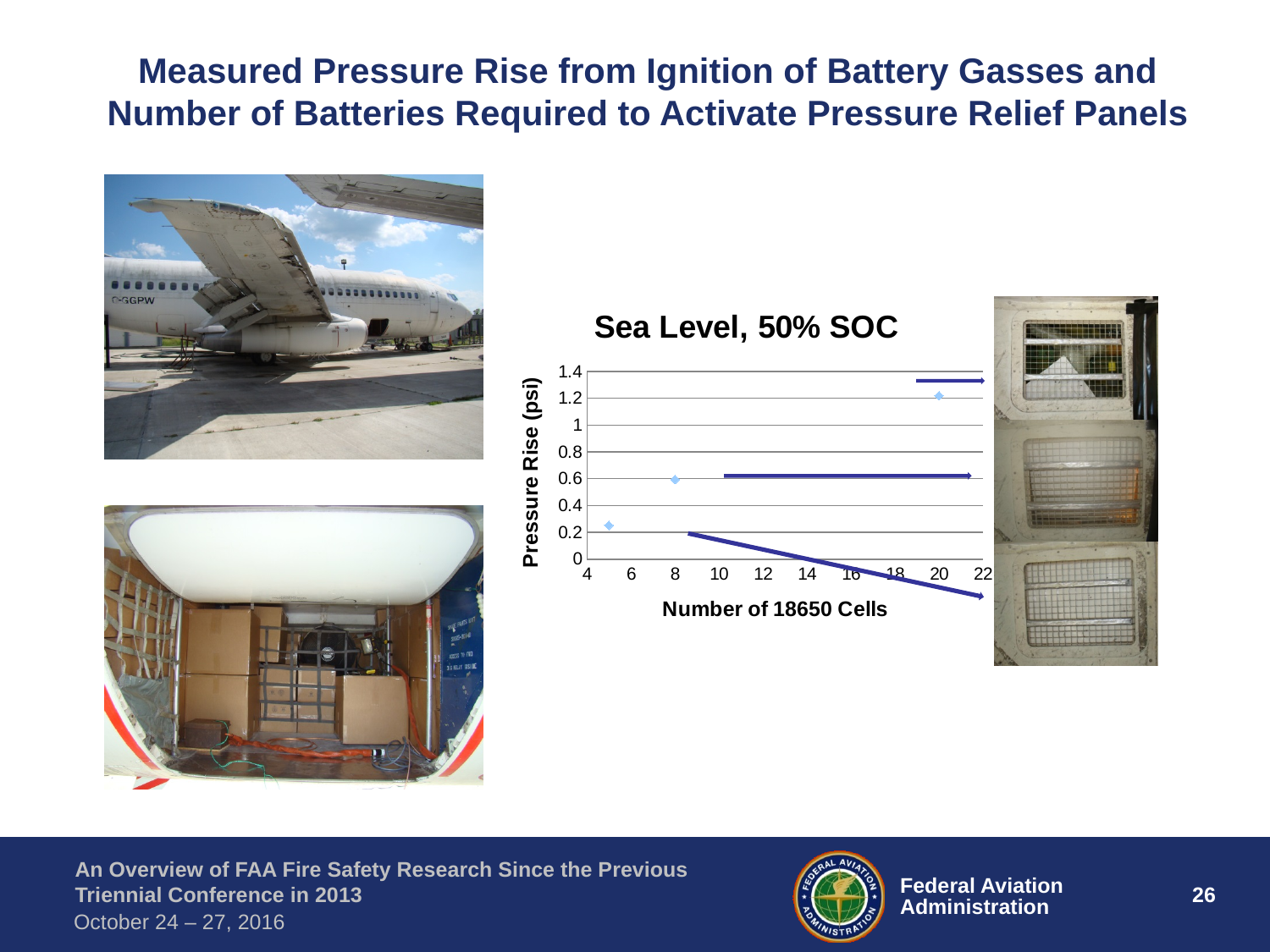
Is the pressure rise for the point at 20 cells greater or less than 1 psi? greater Is the pressure rise for the point at 8 cells greater or less than 0.4 psi? greater What is the title of the chart? Sea Level, 50% SOC Does the pressure rise increase or decrease as the number of 18650 cells increases? increase Which plotted point has the lowest pressure rise? the leftmost point (around 5 cells) What kind of chart is shown on the slide? scatter chart Is the pressure rise for the point at 8 cells greater or less than 0.8 psi? less How many data points are plotted on the chart? 3 Which plotted point has the highest pressure rise? the point at 20 cells What is the label of the chart's x axis? Number of 18650 Cells Which has a larger pressure rise: the point at 8 cells or the point at 20 cells? the point at 20 cells